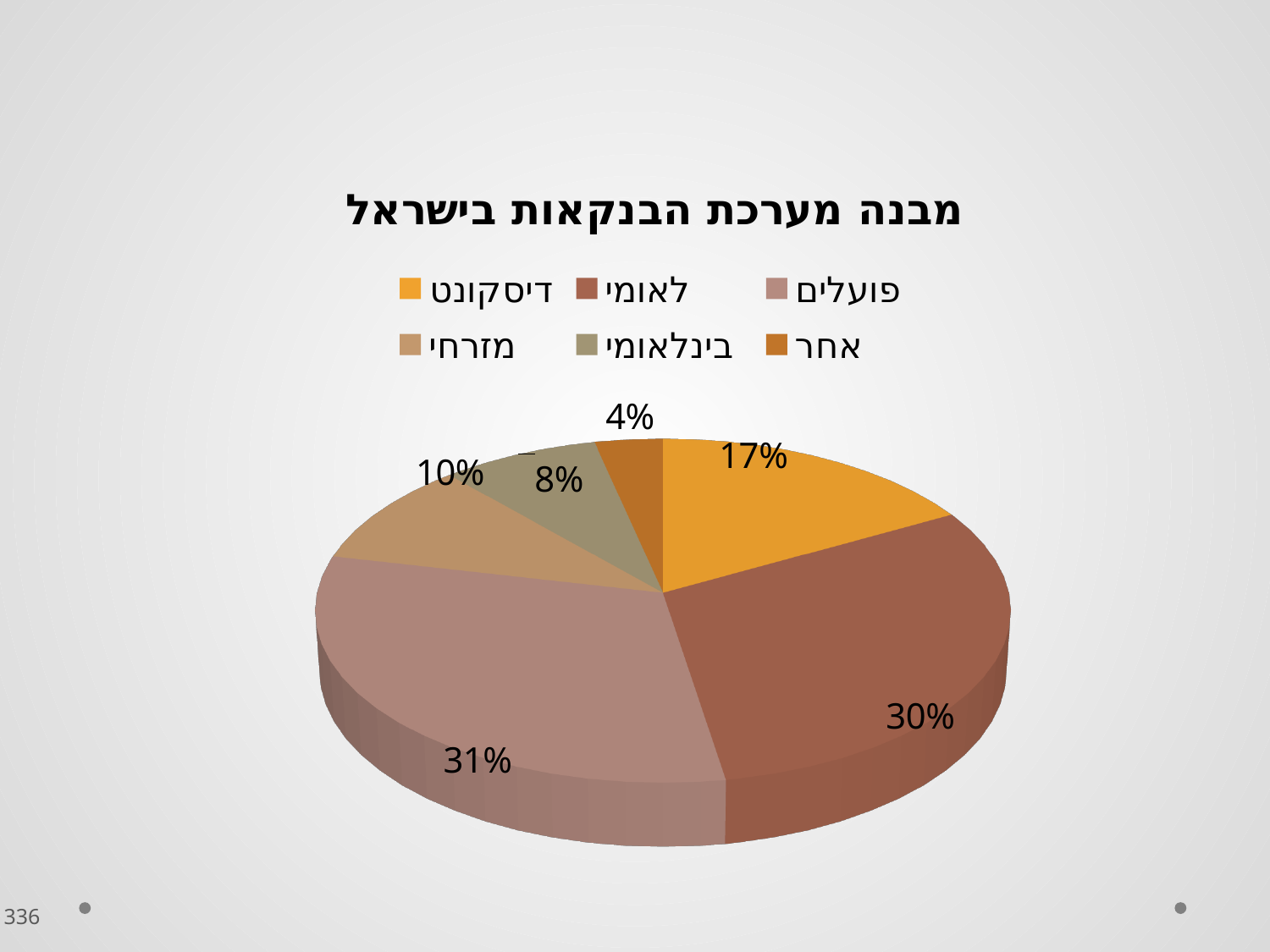
What share of the pie does מזרחי hold? 10% What share of the pie does לאומי hold? 30% What is the title of the chart? מבנה מערכת הבנקאות בישראל Which category has the smallest slice of the pie? אחר What share of the pie does פועלים hold? 31% How many slices does the pie chart have? 6 Which is larger, the share of מזרחי or the share of בינלאומי? מזרחי What type of chart is shown on the slide? Pie chart What share of the pie does דיסקונט hold? 17% What is the difference between the shares of פועלים and דיסקונט? 14% What share of the pie does בינלאומי hold? 8% Which category has the largest slice of the pie? פועלים